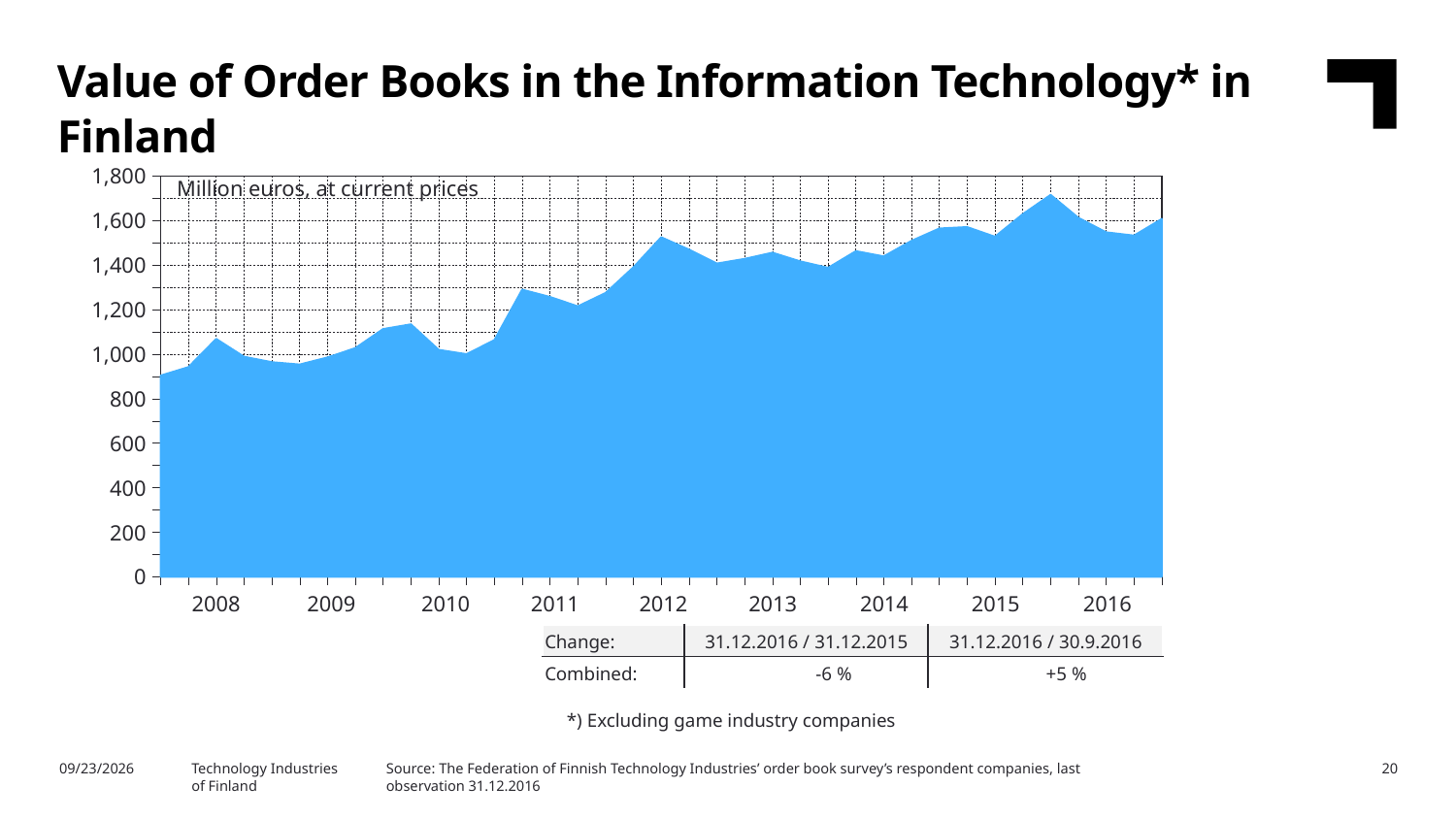
How many years are labelled on the x axis? 9 In what unit are the values on the chart expressed, according to the label inside the plot area? Million euros, at current prices Overall, do the values rise or fall from 2008 to 2016? rise In which year does the chart show its lowest value? 2008 What type of chart is shown on the slide? area chart Is the value in 2009 greater or less than 1,200? less What is the title of the chart? Value of Order Books in the Information Technology* in Finland In which year does the chart reach its highest value? 2015 Is the value at the start of 2008 greater or less than 1,000? less Is the peak value in 2015 greater or less than 1,600? greater What is the combined change for 31.12.2016 / 31.12.2015 shown in the table below the chart? -6 %